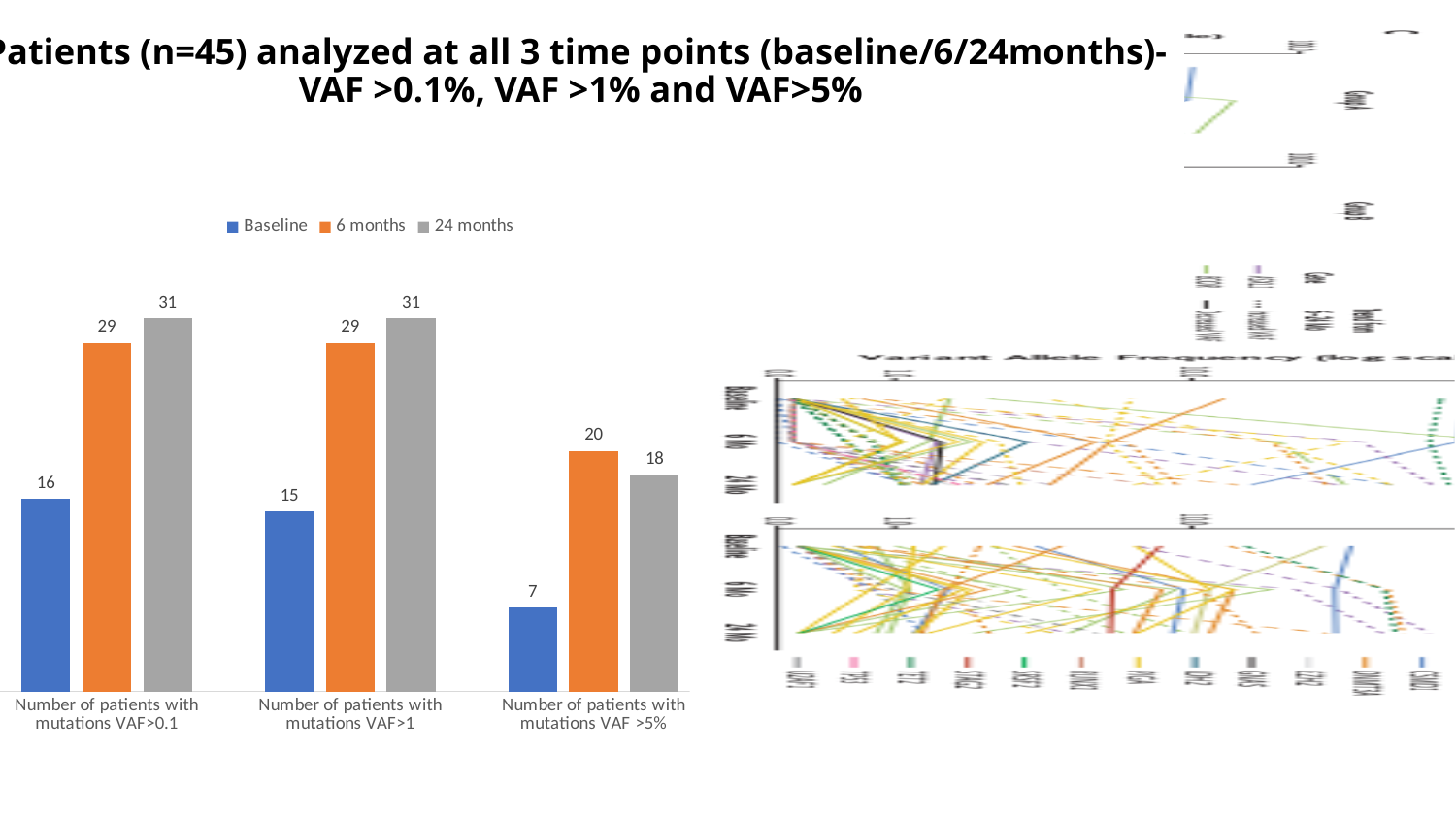
In the bar chart on the left, which category has the lowest Baseline value? Number of patients with mutations VAF >5% In the bar chart on the left, which is larger: the Baseline value for VAF>0.1 or the Baseline value for VAF>1? Baseline value for VAF>0.1 In the bar chart on the left, what is the Baseline value for Number of patients with mutations VAF >5%? 7 How many series does the legend of the bar chart on the left list? 3 What kind of chart is the chart on the left of the slide? Bar chart In the bar chart on the left, what is the difference between the 24 months and Baseline values for Number of patients with mutations VAF>0.1? 15 In the bar chart on the left, what is the 6 months value for Number of patients with mutations VAF >5%? 20 In the bar chart on the left, what is the Baseline value for Number of patients with mutations VAF>0.1? 16 How many categories are shown on the x axis of the bar chart on the left? 3 In the bar chart on the left, what is the 24 months value for Number of patients with mutations VAF>1? 31 In the bar chart on the left, what is the difference between the 6 months and 24 months values for Number of patients with mutations VAF >5%? 2 In the bar chart on the left, which series has the highest value for Number of patients with mutations VAF >5%? 6 months